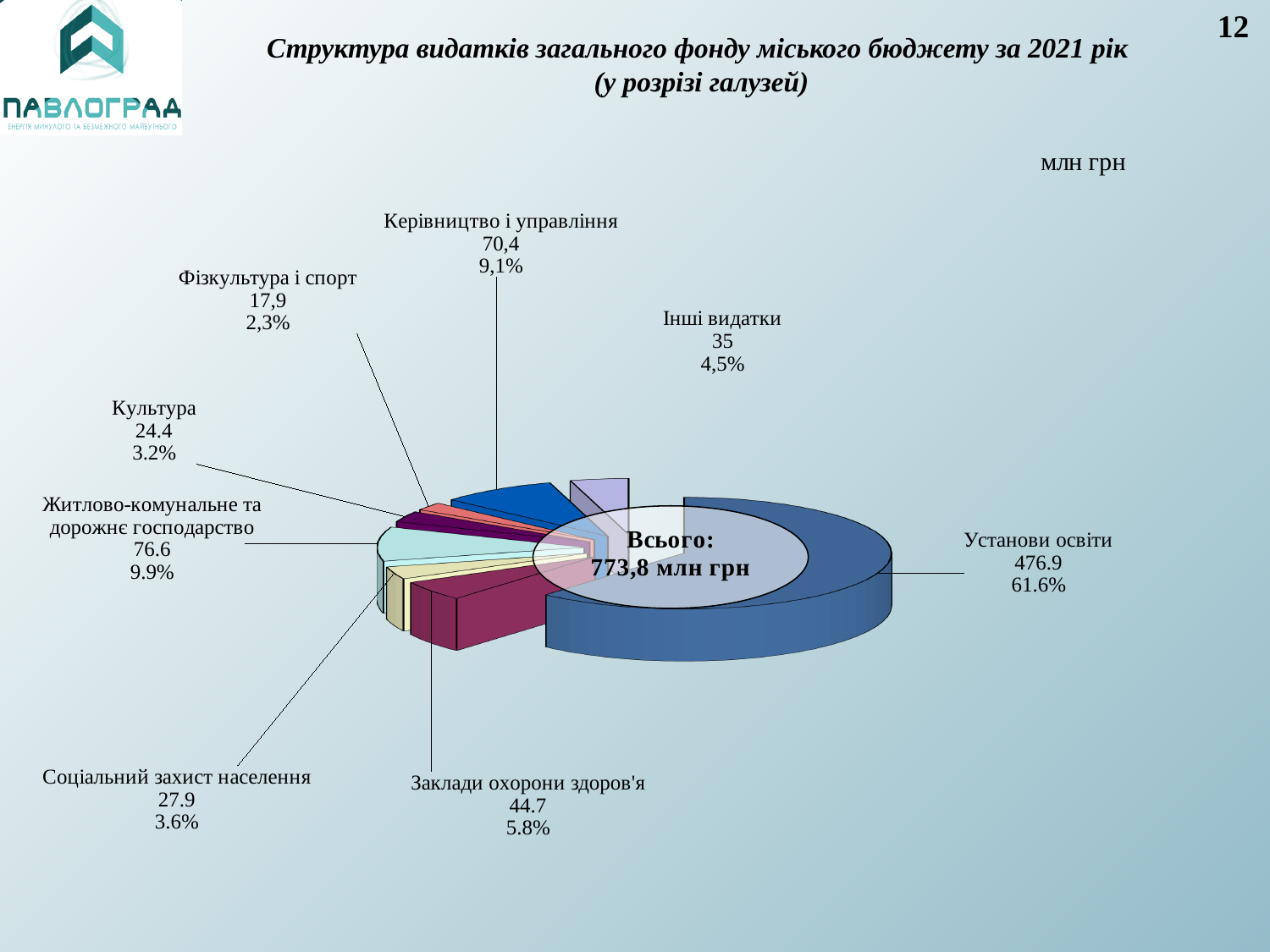
What is the value (млн грн) for Установи освіти? 476.9 What total is shown in the centre of the pie chart? 773,8 млн грн What is the value (млн грн) for Заклади охорони здоров'я? 44.7 Which category has the largest slice of the pie? Установи освіти What is the difference between the values for Житлово-комунальне та дорожнє господарство and Керівництво і управління? 6.2 What percentage is shown for Керівництво і управління? 9,1% What kind of chart is shown on the slide? pie chart What share of the pie does Установи освіти represent? 61.6% How many categories are shown in the pie chart? 8 Which category has the smallest slice of the pie? Фізкультура і спорт What is the value (млн грн) for Житлово-комунальне та дорожнє господарство? 76.6 Which is larger, the value for Культура or the value for Соціальний захист населення? Соціальний захист населення